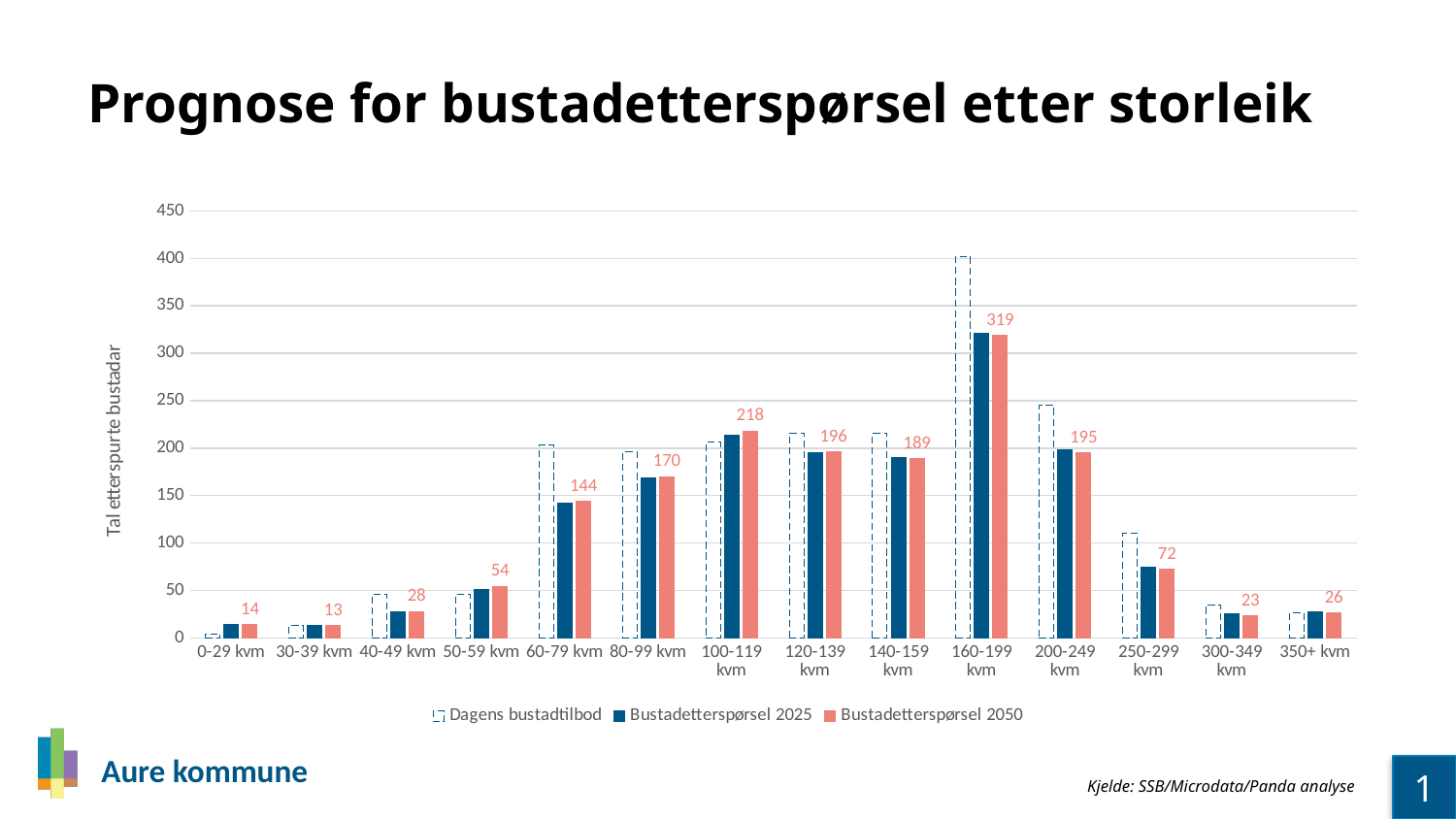
What is the difference between the Bustadetterspørsel 2050 values for 80-99 kvm and 60-79 kvm? 26 How many size categories are shown on the x axis? 14 Is the Dagens bustadtilbod value for 200-249 kvm greater or less than 200? greater What is the Bustadetterspørsel 2050 value for the 100-119 kvm category? 218 What is the difference between the Bustadetterspørsel 2050 values for 160-199 kvm and 200-249 kvm? 124 Which category has the highest Bustadetterspørsel 2050 value? 160-199 kvm Which has the larger Bustadetterspørsel 2050 value, 120-139 kvm or 140-159 kvm? 120-139 kvm Is the Dagens bustadtilbod value for 160-199 kvm greater or less than 350? greater How many series does the legend list? 3 Which category has the lowest Bustadetterspørsel 2050 value? 30-39 kvm What is the Bustadetterspørsel 2050 value for the 160-199 kvm category? 319 What kind of chart is shown on the slide? bar chart